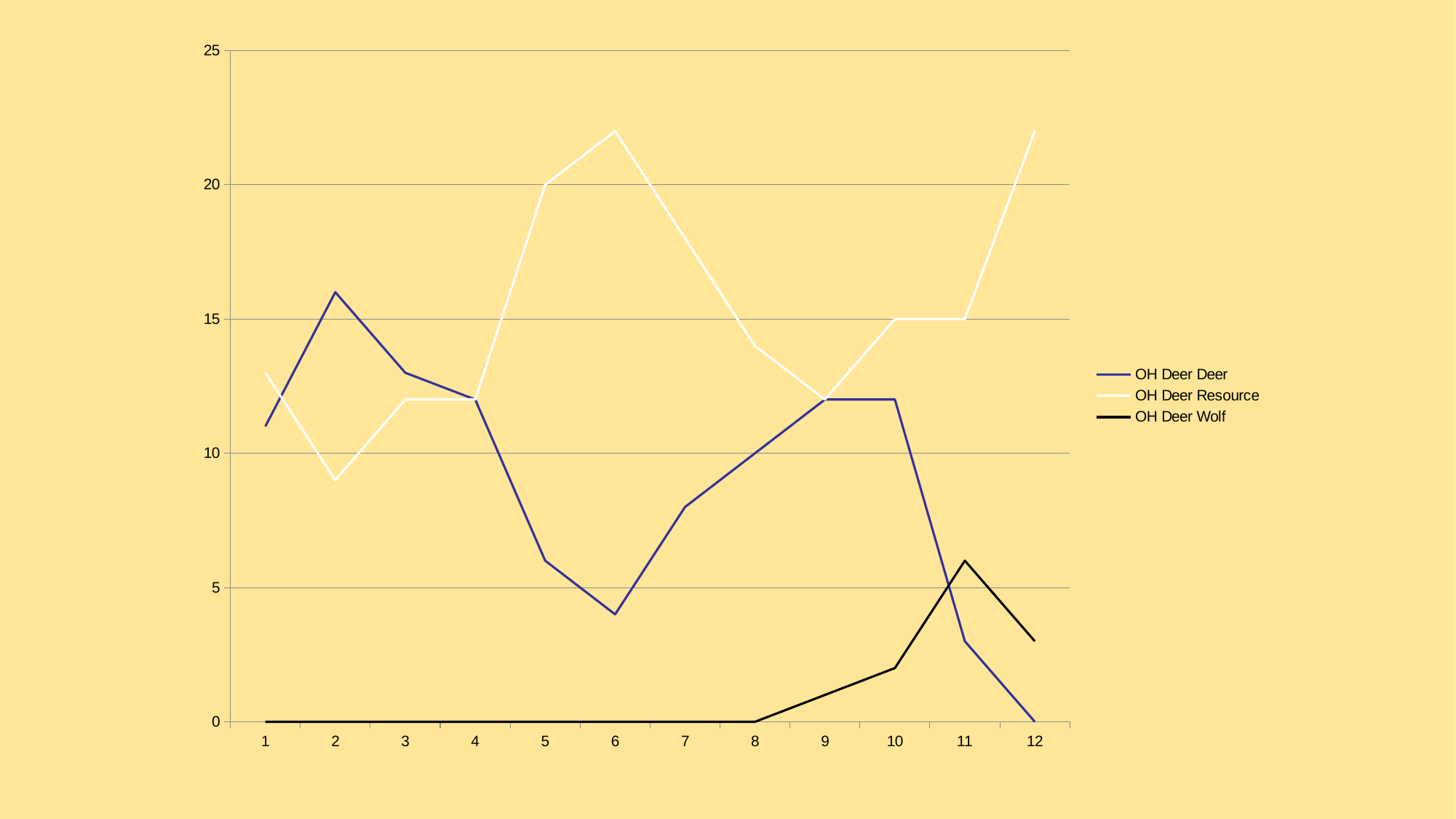
What is the value of OH Deer Deer at x = 12? 0 What is the value of OH Deer Resource at x = 10? 15 What is the value of OH Deer Wolf at x = 4? 0 How many points are plotted along the x axis for each series? 12 At which x value does OH Deer Deer reach its highest point? 2 How many series does the legend list? 3 At which x value does OH Deer Wolf reach its highest point? 11 At x = 5, which series has the larger value, OH Deer Deer or OH Deer Resource? OH Deer Resource What kind of chart is shown on the slide? line chart Is the value for OH Deer Deer at x = 6 greater or less than 5? less Is the value for OH Deer Resource at x = 6 greater or less than 20? greater What is the value of OH Deer Resource at x = 5? 20